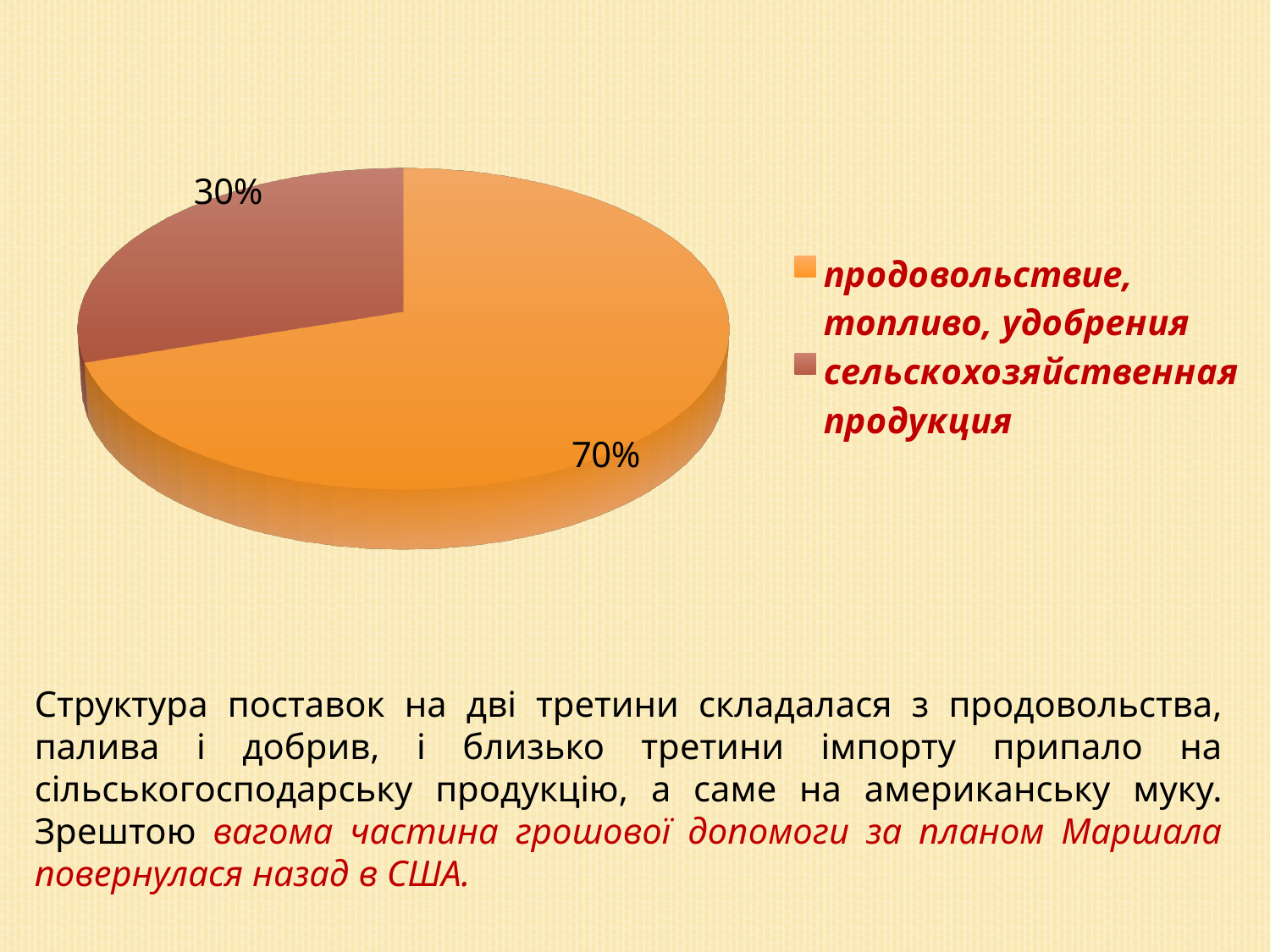
How many slices does the pie chart have? 2 Which category has the largest slice of the pie? продовольствие, топливо, удобрения What kind of chart is shown on the slide? pie chart Which category has the smallest slice of the pie? сельскохозяйственная продукция What share of the pie does "продовольствие, топливо, удобрения" take? 70% Which is larger: the slice for "сельскохозяйственная продукция" or the slice for "продовольствие, топливо, удобрения"? продовольствие, топливо, удобрения What is the difference in percentage points between the two slices? 40% How many entries does the legend list? 2 What colour is the slice for "сельскохозяйственная продукция"? brown What share of the pie does "сельскохозяйственная продукция" take? 30% What colour is the slice for "продовольствие, топливо, удобрения"? orange